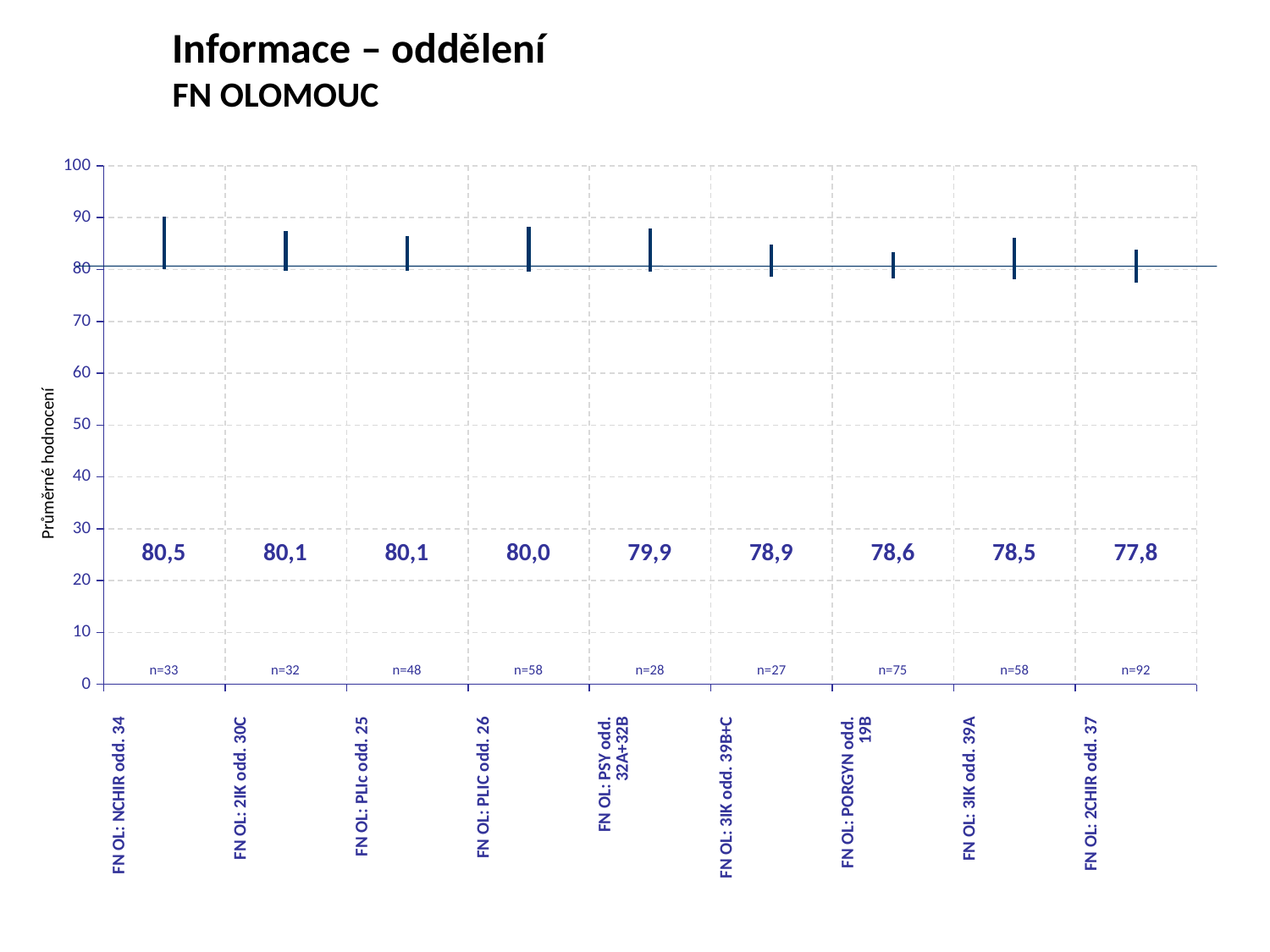
What is the value for FN OL: NCHIR odd. 34? 80,5 What is the value for FN OL: 2CHIR odd. 37? 77,8 What is the value for FN OL: PORGYN odd. 19B? 78,6 What is the sample size (n) shown for FN OL: 2CHIR odd. 37? n=92 Which is larger, the value for FN OL: 3IK odd. 39B+C or the value for FN OL: 3IK odd. 39A? FN OL: 3IK odd. 39B+C Do the values rise or fall from left to right along the x axis? fall How many departments are shown on the x axis? 9 What is the label of the y axis? Průměrné hodnocení What is the value for FN OL: PSY odd. 32A+32B? 79,9 What is the difference between the values for FN OL: NCHIR odd. 34 and FN OL: 2CHIR odd. 37? 2,7 Which department has the highest value? FN OL: NCHIR odd. 34 Which department has the lowest value? FN OL: 2CHIR odd. 37